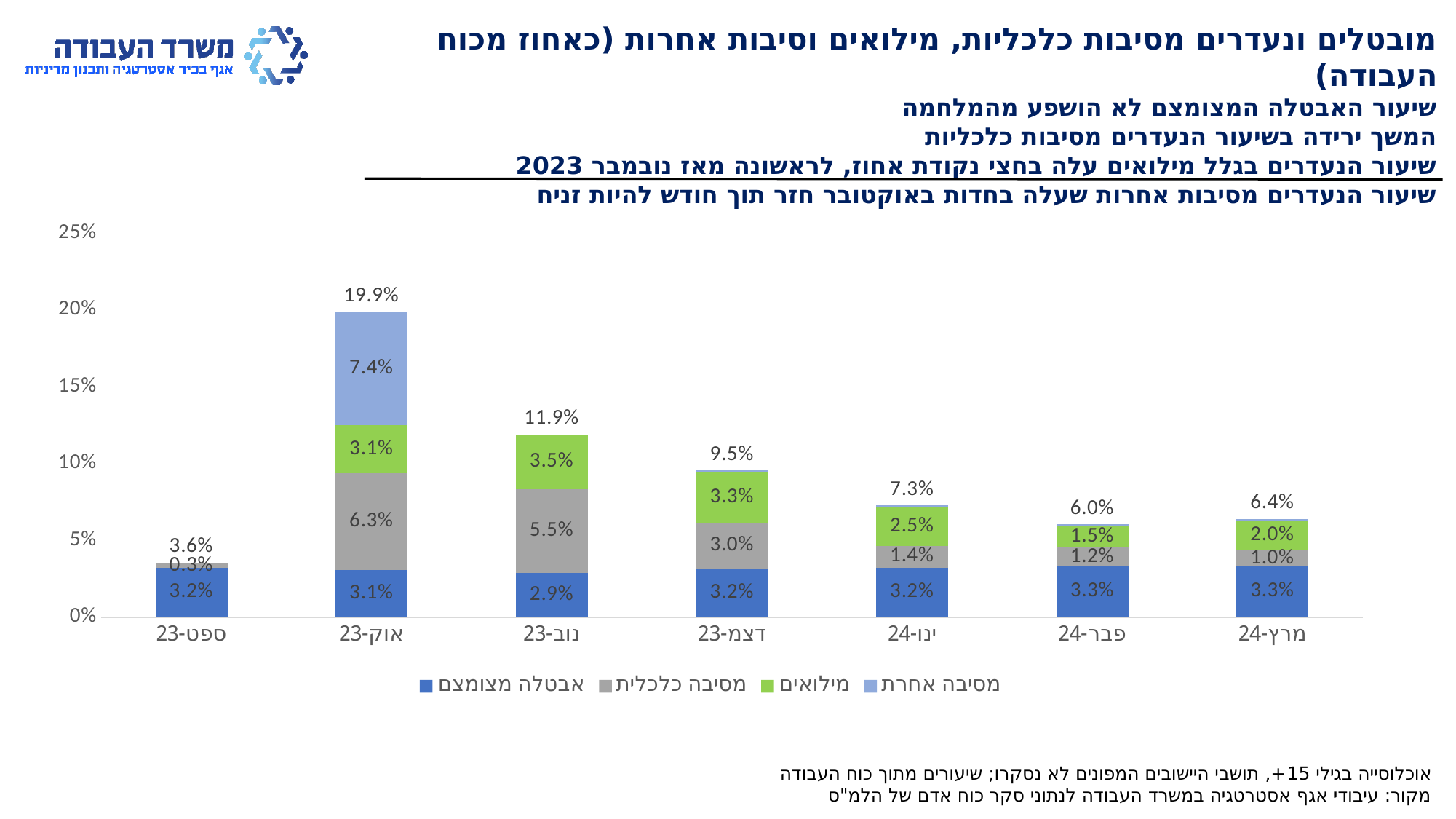
How many months (categories) are shown on the x axis? 7 What is the value of the אבטלה מצומצם segment for מרץ-24? 3.3% Is the total for ינו-24 greater or less than 10%? less Which month has the highest total bar? אוק-23 What is the difference between the total for נוב-23 and the total for דצמ-23? 2.4% Which month has the lowest total bar? ספט-23 What is the total value printed above the bar for אוק-23? 19.9% What is the value of the מילואים segment for נוב-23? 3.5% What type of chart is shown on the slide? stacked bar chart What is the value of the מסיבה כלכלית segment for אוק-23? 6.3% Is the total for פבר-24 larger or smaller than the total for מרץ-24? smaller How many series does the legend list? 4